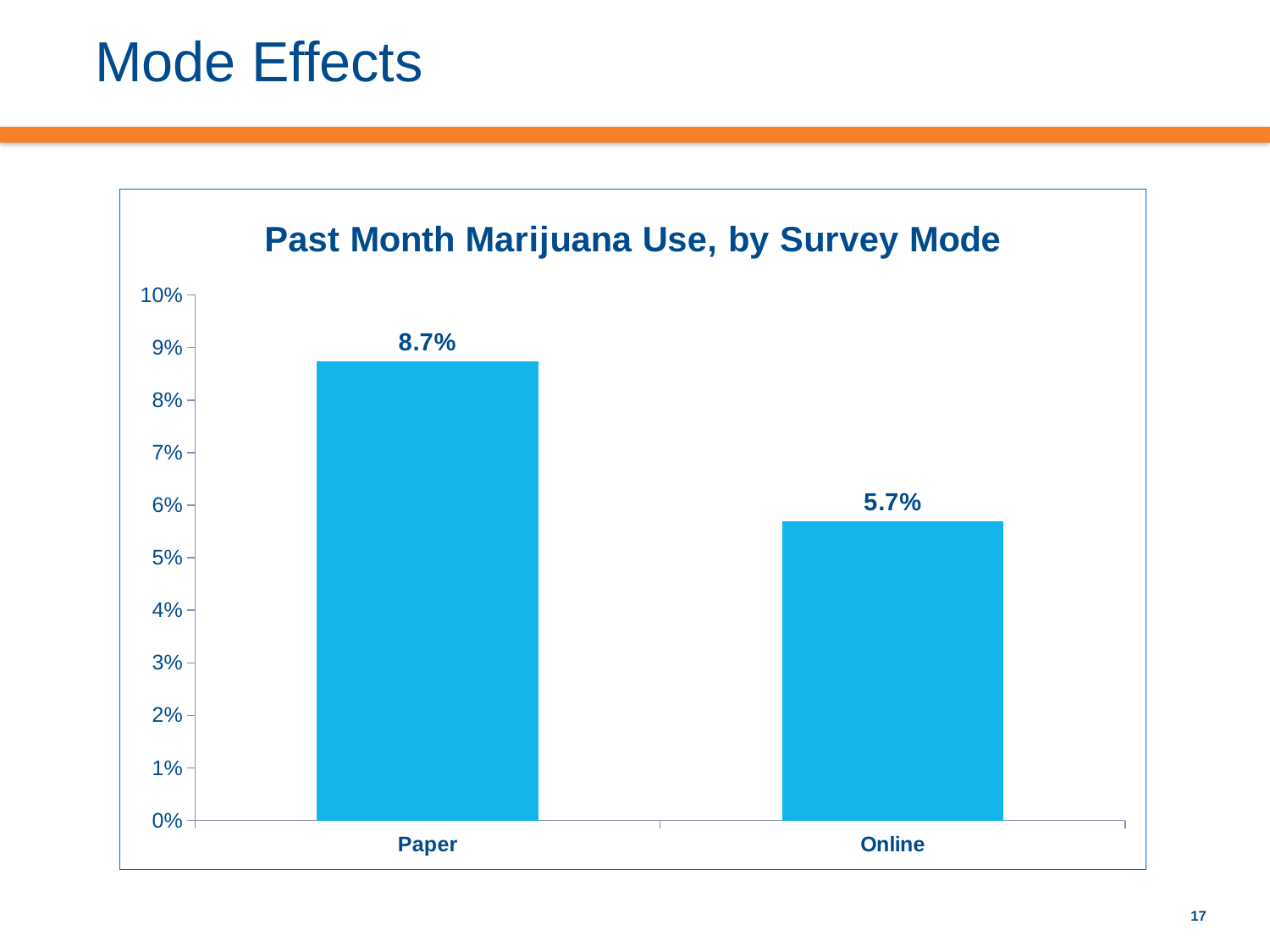
What is the past month marijuana use value for the Paper survey mode? 8.7% What kind of chart is shown on the slide? bar chart Is the value for Paper greater or less than 8%? greater What is the maximum value shown on the vertical axis? 10% Which is larger, the value for Paper or the value for Online? Paper What is the difference between the Paper and Online values? 3.0% Is the value for Online greater or less than 6%? less What is the title of the chart? Past Month Marijuana Use, by Survey Mode Which survey mode has the highest past month marijuana use? Paper How many survey modes are shown on the chart? 2 Which survey mode has the lowest past month marijuana use? Online What is the past month marijuana use value for the Online survey mode? 5.7%